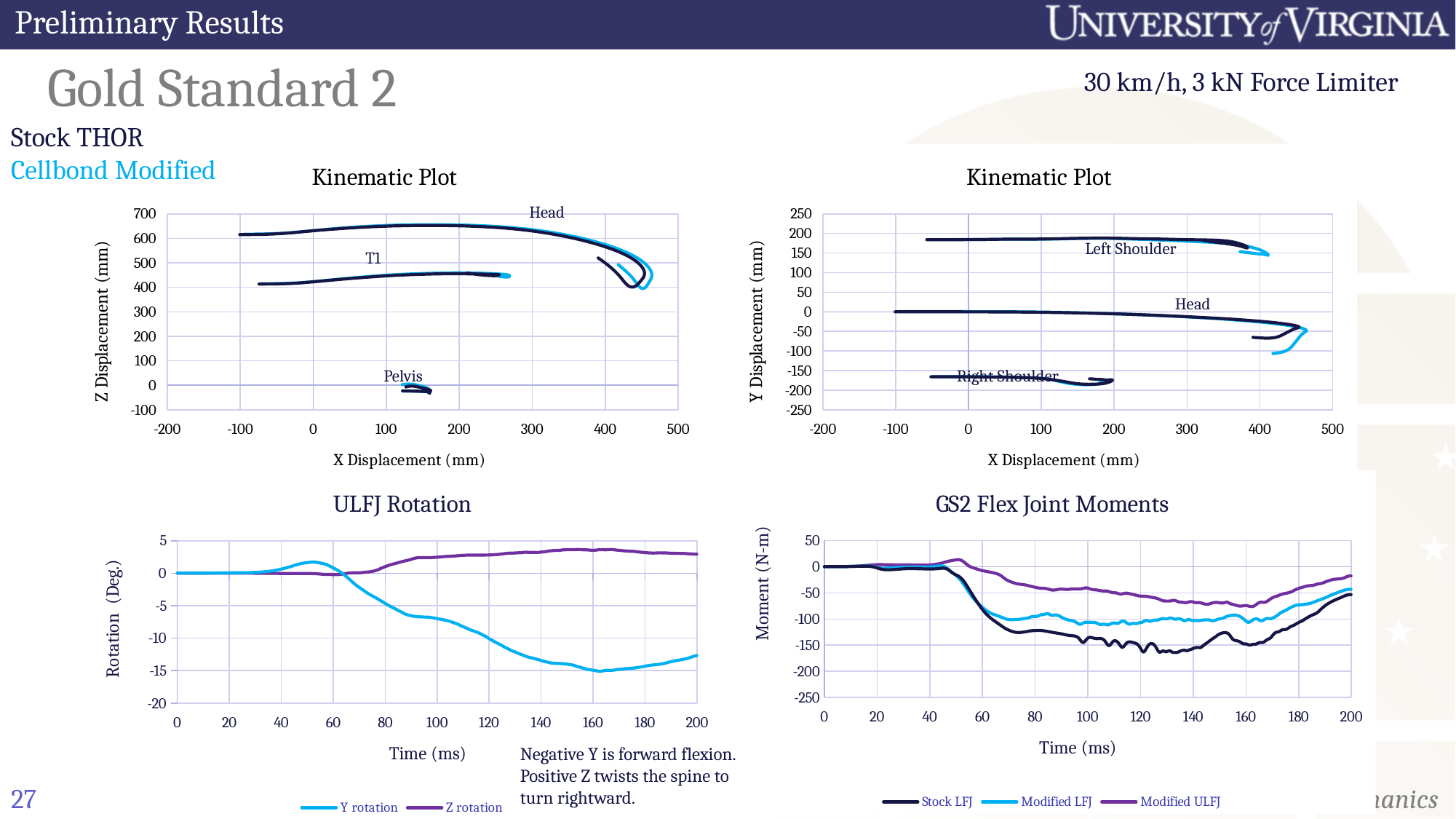
In the GS2 Flex Joint Moments chart, how many series does the legend list? 3 In the ULFJ Rotation chart, does the Y rotation series rise or fall between 60 ms and 160 ms? fall In the top-left Kinematic Plot, which labelled trace has the highest Z displacement? Head In the ULFJ Rotation chart, is the Z rotation value at 200 ms greater or less than 0? greater In the GS2 Flex Joint Moments chart, which series reaches the lowest moment? Stock LFJ In the ULFJ Rotation chart, is the lowest value of the Y rotation series greater or less than -10? less In the GS2 Flex Joint Moments chart, is the Stock LFJ value at 120 ms greater or less than -100? less In the ULFJ Rotation chart, which series has the higher value at 160 ms, Y rotation or Z rotation? Z rotation In the ULFJ Rotation chart, how many series does the legend list? 2 What kind of chart is the ULFJ Rotation chart? line chart